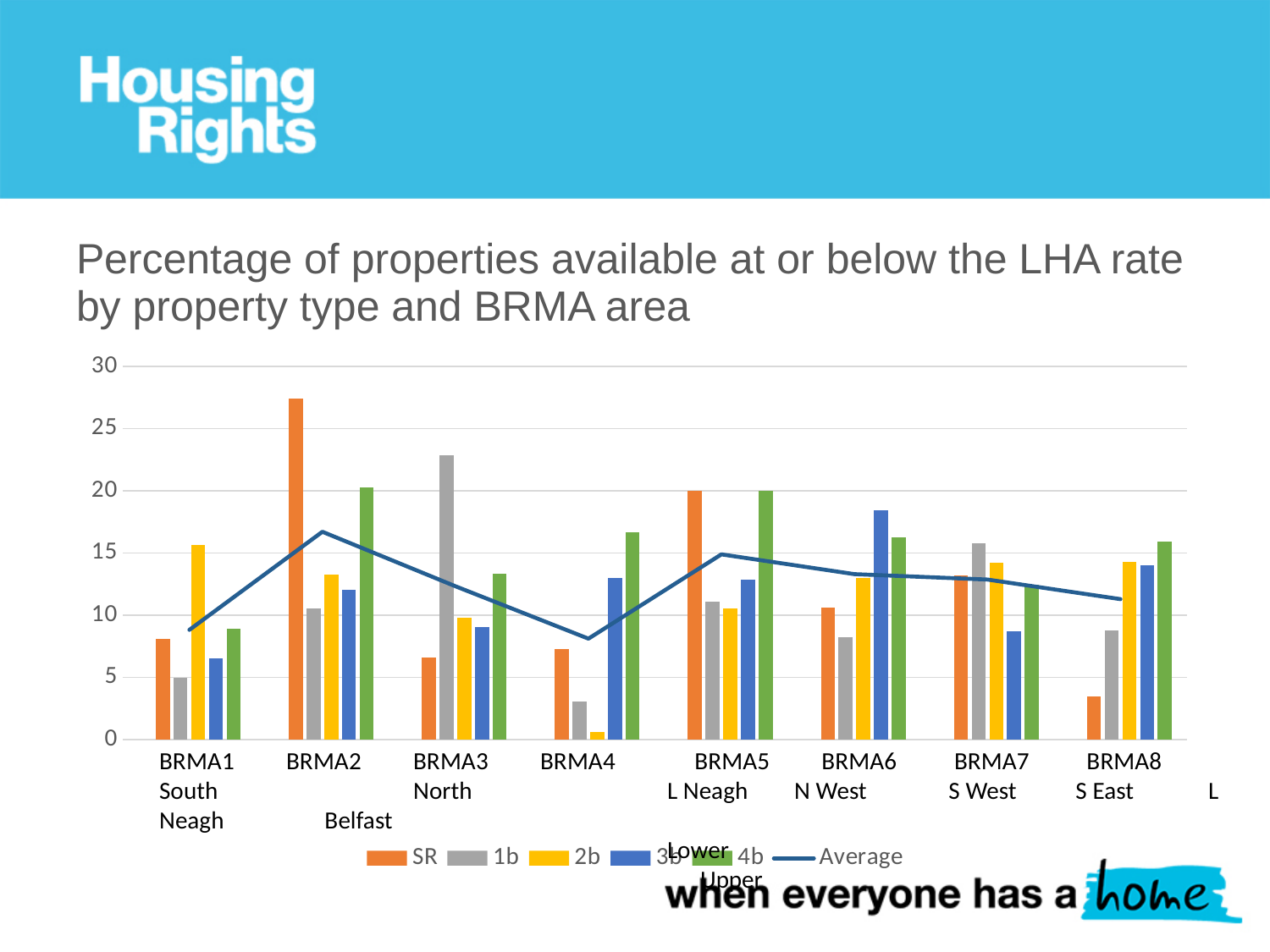
Which BRMA area has the lowest SR bar? BRMA8 S East Is the 1b value for BRMA3 North greater or less than 20? greater Is the SR value for BRMA8 S East greater or less than 5? less Is the SR value for BRMA2 Belfast greater or less than 25? greater Which BRMA area has the lowest 2b bar? BRMA4 How many series does the legend list? 6 Which BRMA area has the highest 1b bar? BRMA3 North Which is larger, the 3b value for BRMA6 N West or the 3b value for BRMA1 South Neagh? BRMA6 N West Which BRMA area has the highest SR bar? BRMA2 Belfast How many BRMA areas are shown on the x axis? 8 What kind of chart is shown on the slide? Bar chart (with an Average line)